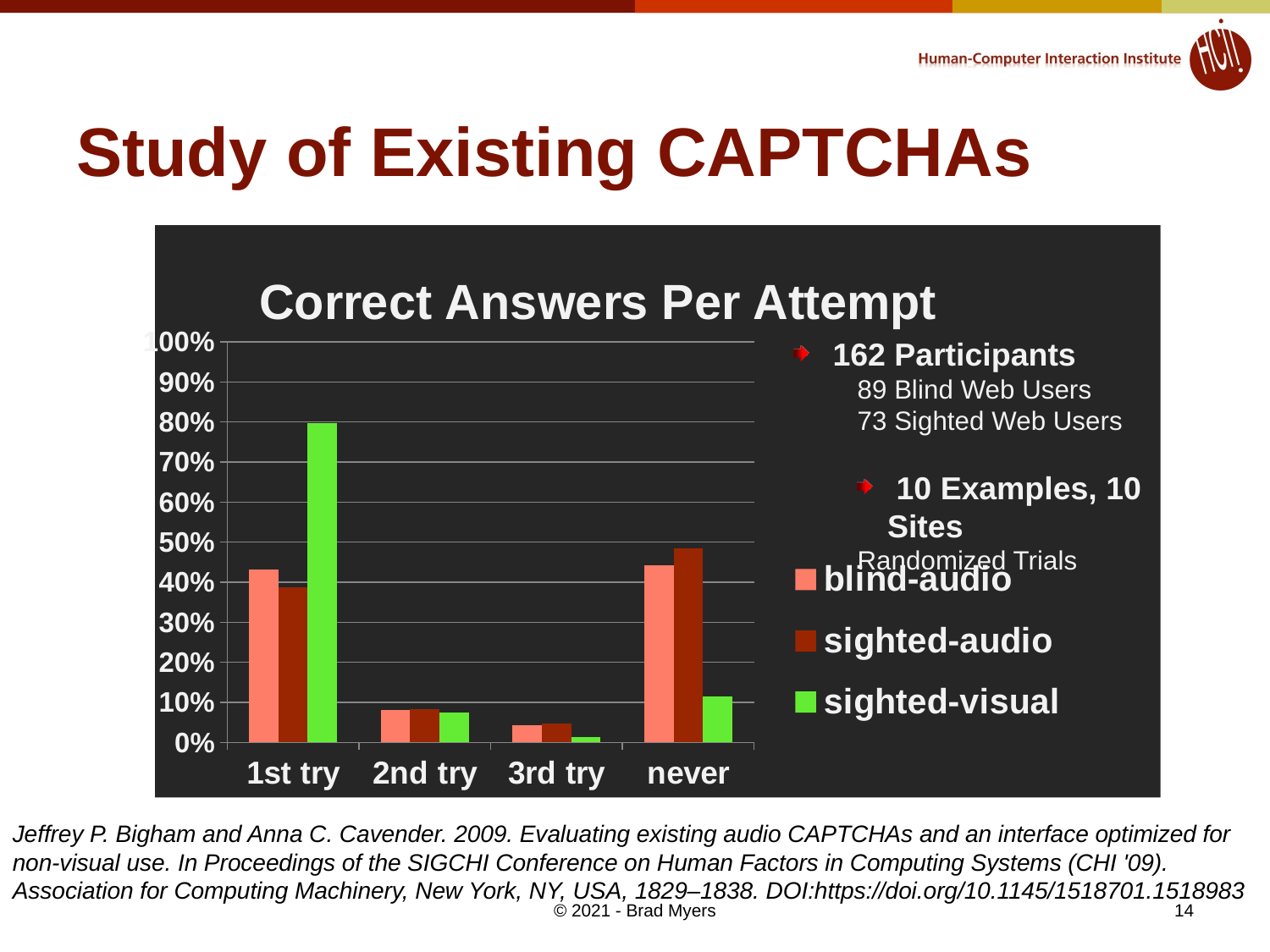
Is the sighted-visual value for '1st try' greater or less than 70%? greater Which series has the highest value for the '1st try' category? sighted-visual What is the title of the chart? Correct Answers Per Attempt Is the blind-audio value for '1st try' greater or less than 50%? less For the sighted-visual series, which category has the highest value? 1st try How many categories are shown on the x axis of the chart? 4 How many series does the chart legend list? 3 For the sighted-audio series, which is larger: the value for '1st try' or the value for 'never'? never Is the sighted-visual value for 'never' greater or less than 20%? less What type of chart is shown on the slide? bar chart Which series is shown in green in the chart? sighted-visual Which series has the lowest value for the 'never' category? sighted-visual